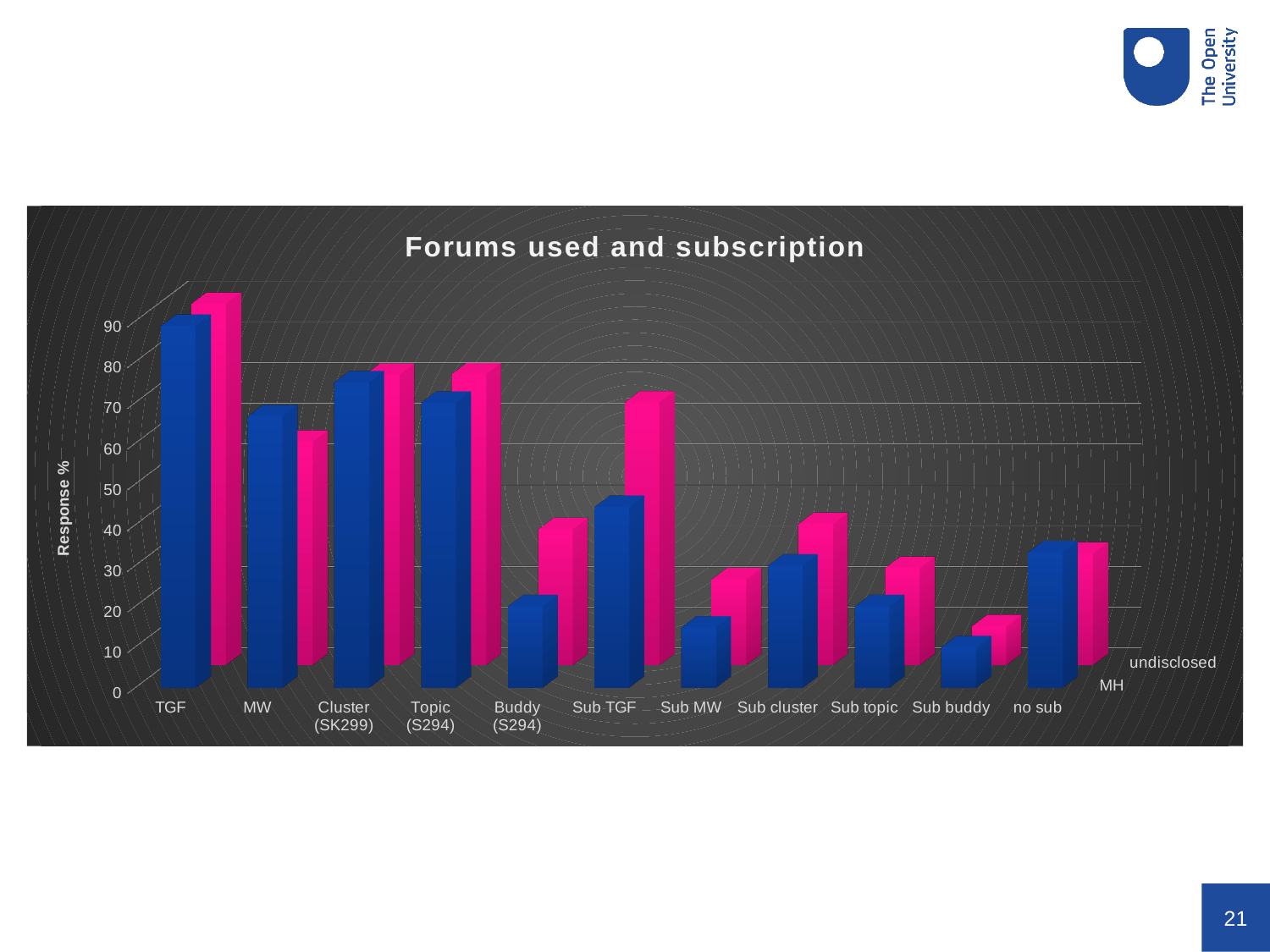
How many series does the chart show? 2 Which category has the highest MH value? TGF What kind of chart is shown on the slide? bar chart Is the MH value for TGF greater or less than 70? greater Is the undisclosed value for Sub TGF greater or less than 50? greater What is the label of the vertical axis? Response % For Buddy (S294), which series has the larger value, MH or undisclosed? undisclosed For Sub TGF, which series has the larger value, MH or undisclosed? undisclosed How many categories are shown on the x axis of the chart? 11 Which category has the lowest undisclosed value? Sub buddy What is the title of the chart? Forums used and subscription Is the MH value for Sub buddy greater or less than 20? less